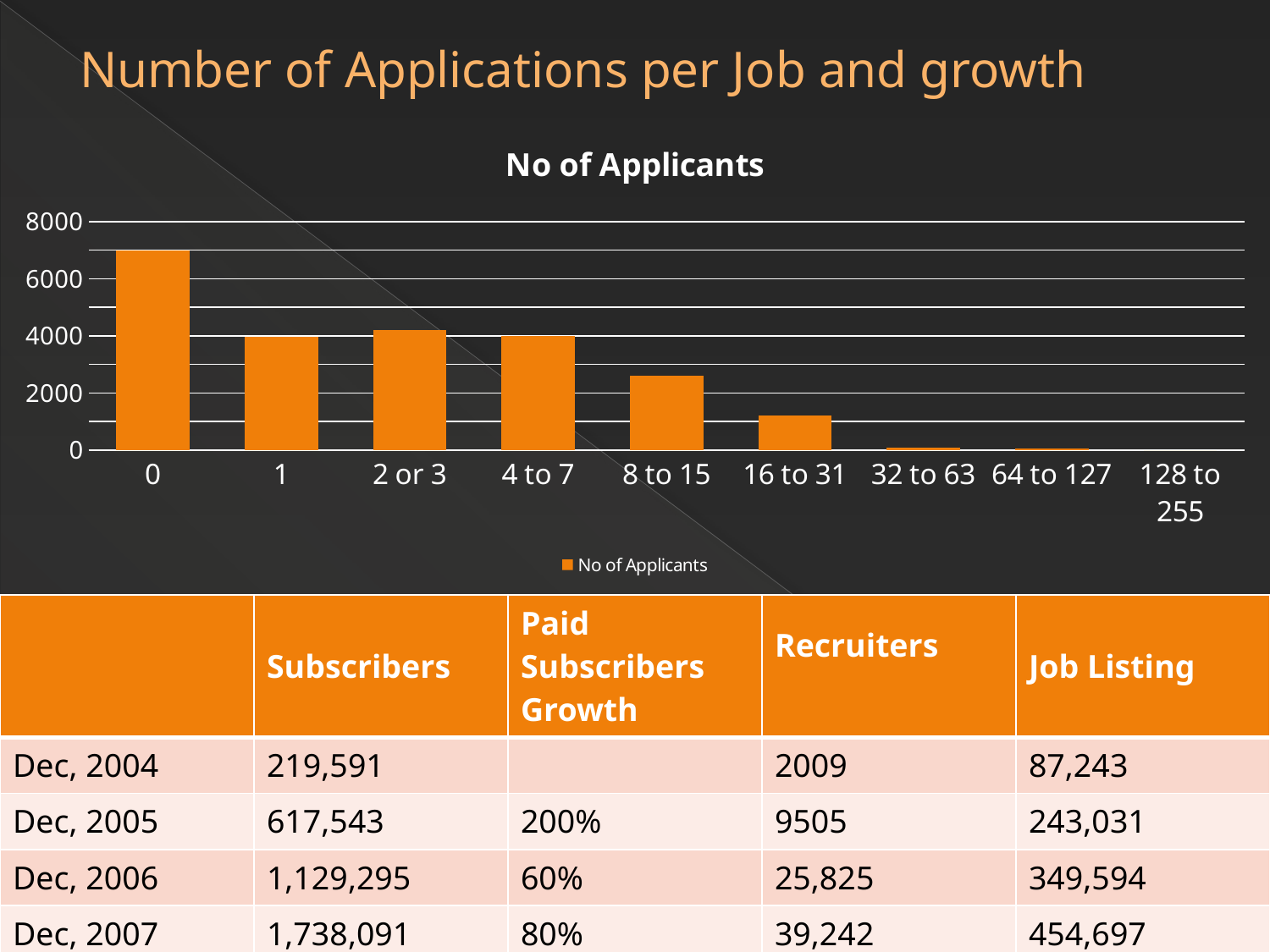
How many series does the legend of the No of Applicants chart list? 1 Is the value for the category 8 to 15 greater or less than 2000? greater Is the value for the category 0 greater or less than 6000? greater Is the value for the category 1 greater or less than 6000? less Which is larger, the value for 8 to 15 or the value for 16 to 31? 8 to 15 How many categories are shown on the x axis of the No of Applicants chart? 9 What is the title of the chart on the slide? No of Applicants Which category has the highest number of applicants in the chart? 0 Do the values in the chart generally rise or fall from left to right along the x axis? fall Which is larger, the value for category 0 or the value for category 1? 0 What kind of chart is shown on the slide? bar chart